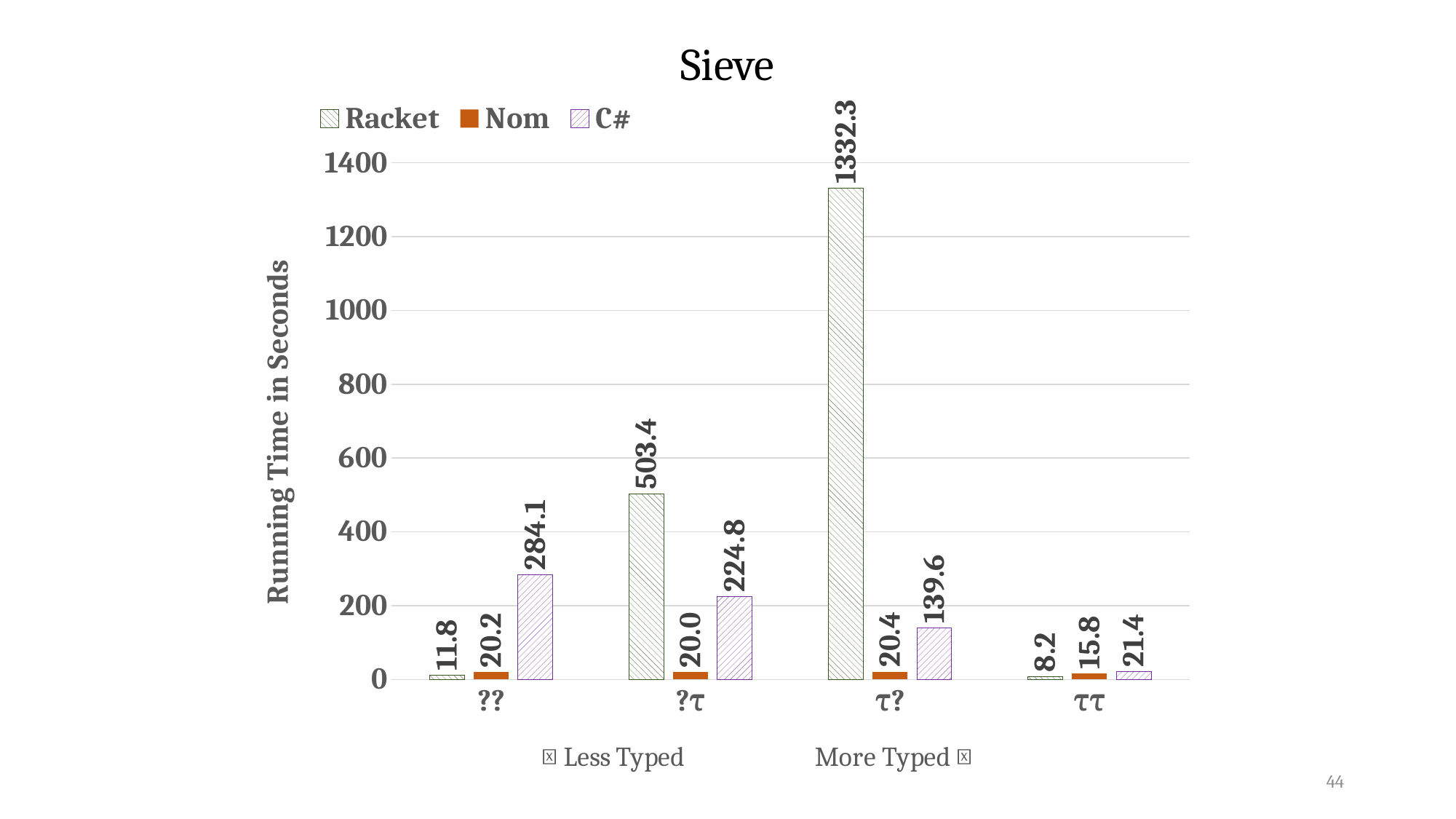
Which category has the lowest C# running time? ττ What is the difference between the Racket and C# running times in the ?τ category? 278.6 What is the label of the y axis? Running Time in Seconds What is the title of the chart? Sieve What is the running time for C# in the ?? category? 284.1 Which category has the highest Racket running time? τ? What is the running time for Nom in the ττ category? 15.8 What is the running time for Racket in the τ? category? 1332.3 In the ?? category, which is larger: the Racket running time or the Nom running time? Nom How many categories are shown on the x axis? 4 How many series does the legend list? 3 What type of chart is shown on the slide? bar chart